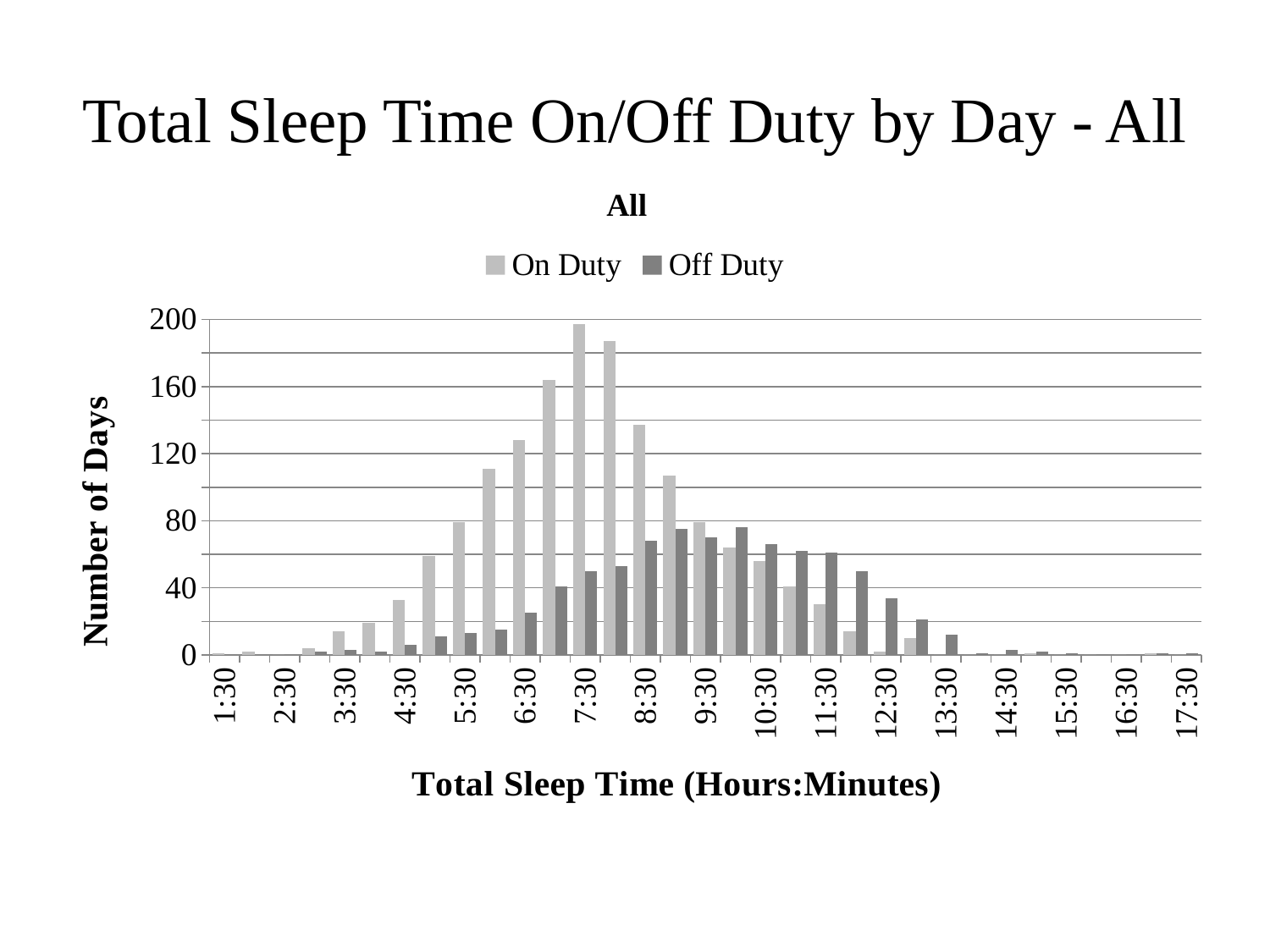
How many series does the legend list? 2 Is the Off Duty value at 10:30 greater or less than 40? greater At which labeled sleep time is the On Duty bar highest? 7:30 What kind of chart is shown on the slide? bar chart Is the Off Duty value at 6:30 greater or less than 40? less Is the On Duty value at 8:30 greater or less than 120? greater Do the On Duty values rise or fall from 7:30 to 11:30? fall What is the label of the vertical axis? Number of Days At 11:30, which series has the larger value, On Duty or Off Duty? Off Duty What are the two series named in the legend? On Duty and Off Duty At 6:30, which series has the larger value, On Duty or Off Duty? On Duty